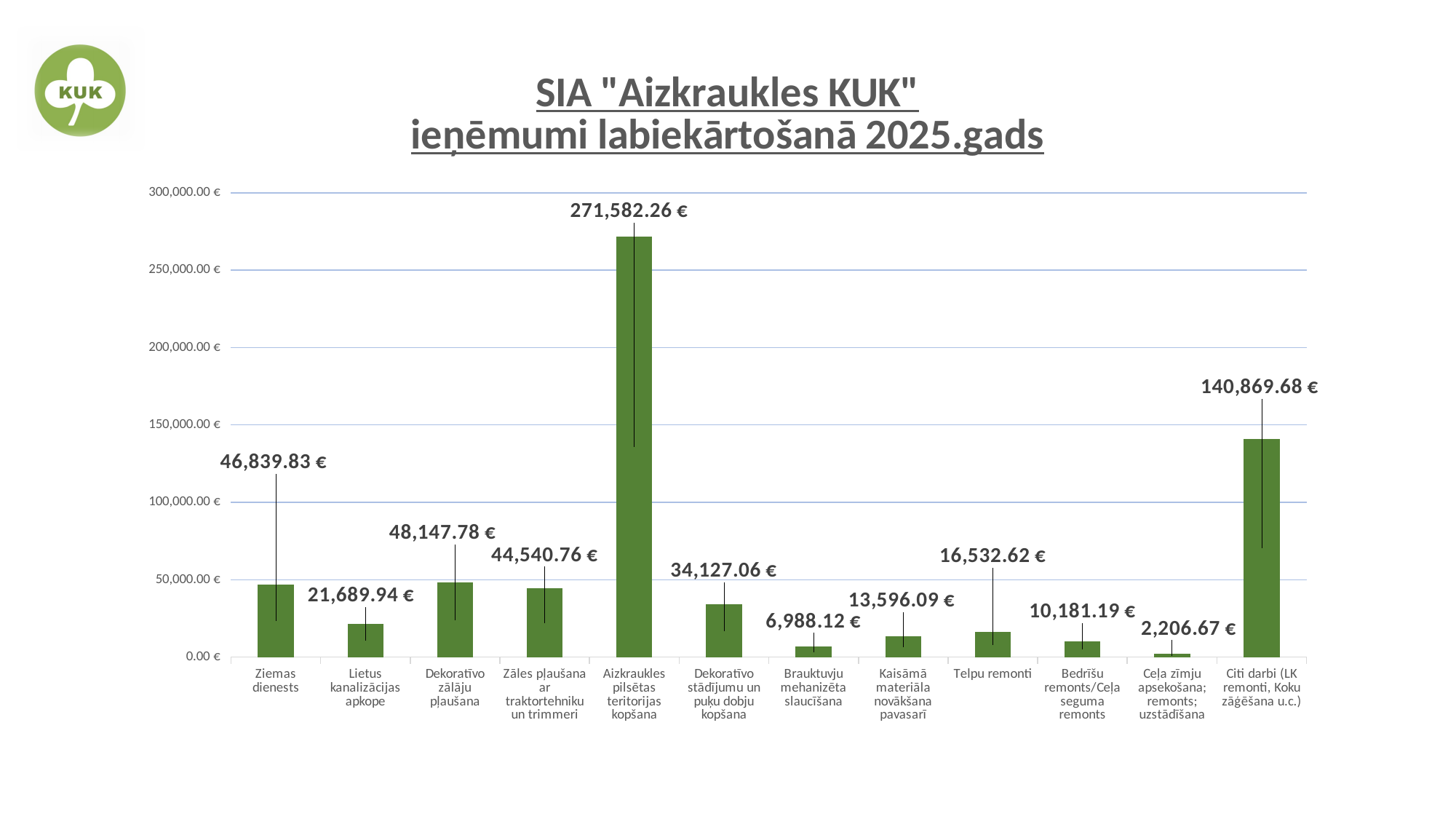
Which is larger: the value for Dekoratīvo zālāju pļaušana or the value for Dekoratīvo stādījumu un puķu dobju kopšana? Dekoratīvo zālāju pļaušana What is the value for Ceļa zīmju apsekošana; remonts; uzstādīšana? 2,206.67 € What is the value for Telpu remonti? 16,532.62 € Which category has the highest value? Aizkraukles pilsētas teritorijas kopšana What is the value for Ziemas dienests? 46,839.83 € What is the difference between the values for Aizkraukles pilsētas teritorijas kopšana and Citi darbi (LK remonti, Koku zāģēšana u.c.)? 130,712.58 € What is the difference between the values for Telpu remonti and Kaisāmā materiāla novākšana pavasarī? 2,936.53 € Is the value for Citi darbi (LK remonti, Koku zāģēšana u.c.) greater or less than 100,000.00 €? greater What kind of chart is shown on the slide? bar chart How many categories are shown on the x axis? 12 What is the value for Aizkraukles pilsētas teritorijas kopšana? 271,582.26 € Which category has the lowest value? Ceļa zīmju apsekošana; remonts; uzstādīšana